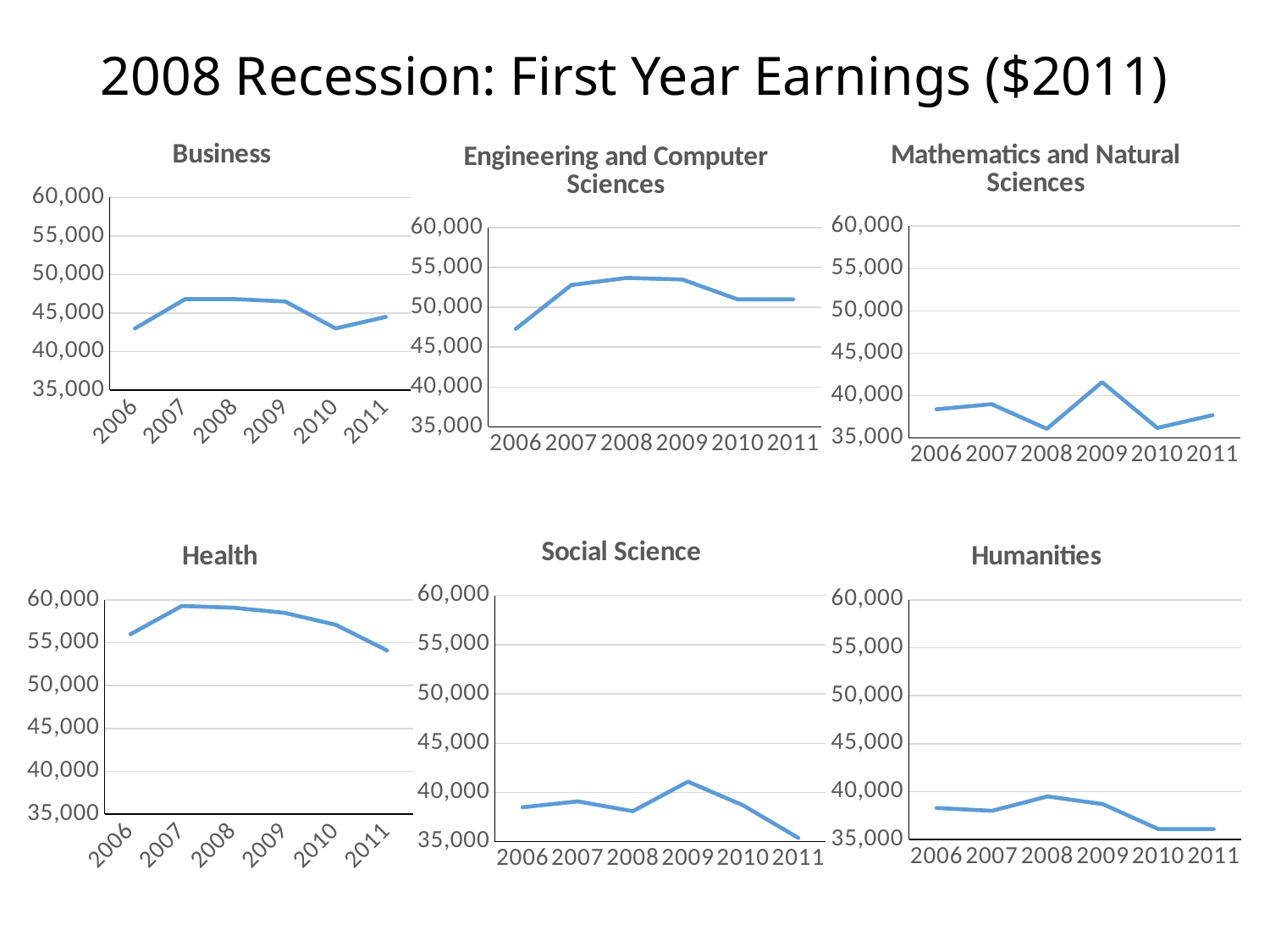
On the Humanities chart, is the value for 2011 greater or less than 40,000? less On the Mathematics and Natural Sciences chart, which year has the highest earnings? 2009 On the Social Science chart, which year has the highest earnings? 2009 On the Health chart, do earnings rise or fall from 2007 to 2011? fall On the Engineering and Computer Sciences chart, is the value for 2006 greater or less than 50,000? less On the Engineering and Computer Sciences chart, which year has the lowest earnings? 2006 On the Health chart, is the value for 2006 greater or less than 55,000? greater On the Health chart, which year has the lowest earnings? 2011 On the Business chart, which year has the larger value, 2007 or 2010? 2007 How many years are plotted on the Business chart? 6 How many charts are shown on the slide? 6 What kind of chart is the Business chart? line chart